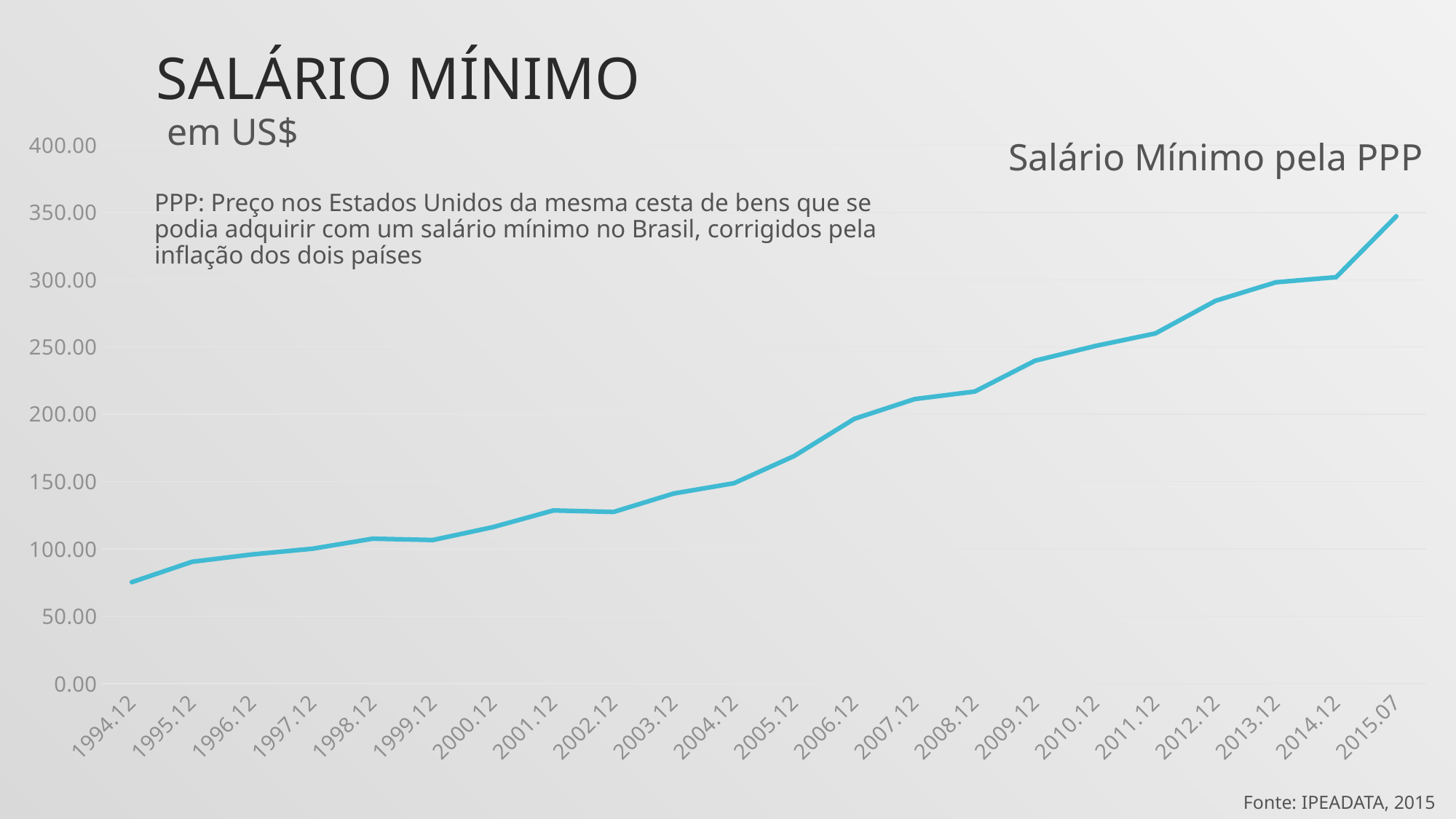
Is the value for 2015.07 greater or less than 300.00? greater Which period has the lowest value? 1994.12 How many data points are plotted along the x axis? 22 Do the values generally rise or fall from 1994.12 to 2015.07? rise Is the value for 1994.12 greater or less than 100.00? less Which is larger, the value for 2010.12 or the value for 2000.12? 2010.12 What kind of chart is shown on the slide? line chart Is the value for 2012.12 greater or less than 250.00? greater Which period has the highest value? 2015.07 What is the title of the chart? Salário Mínimo pela PPP